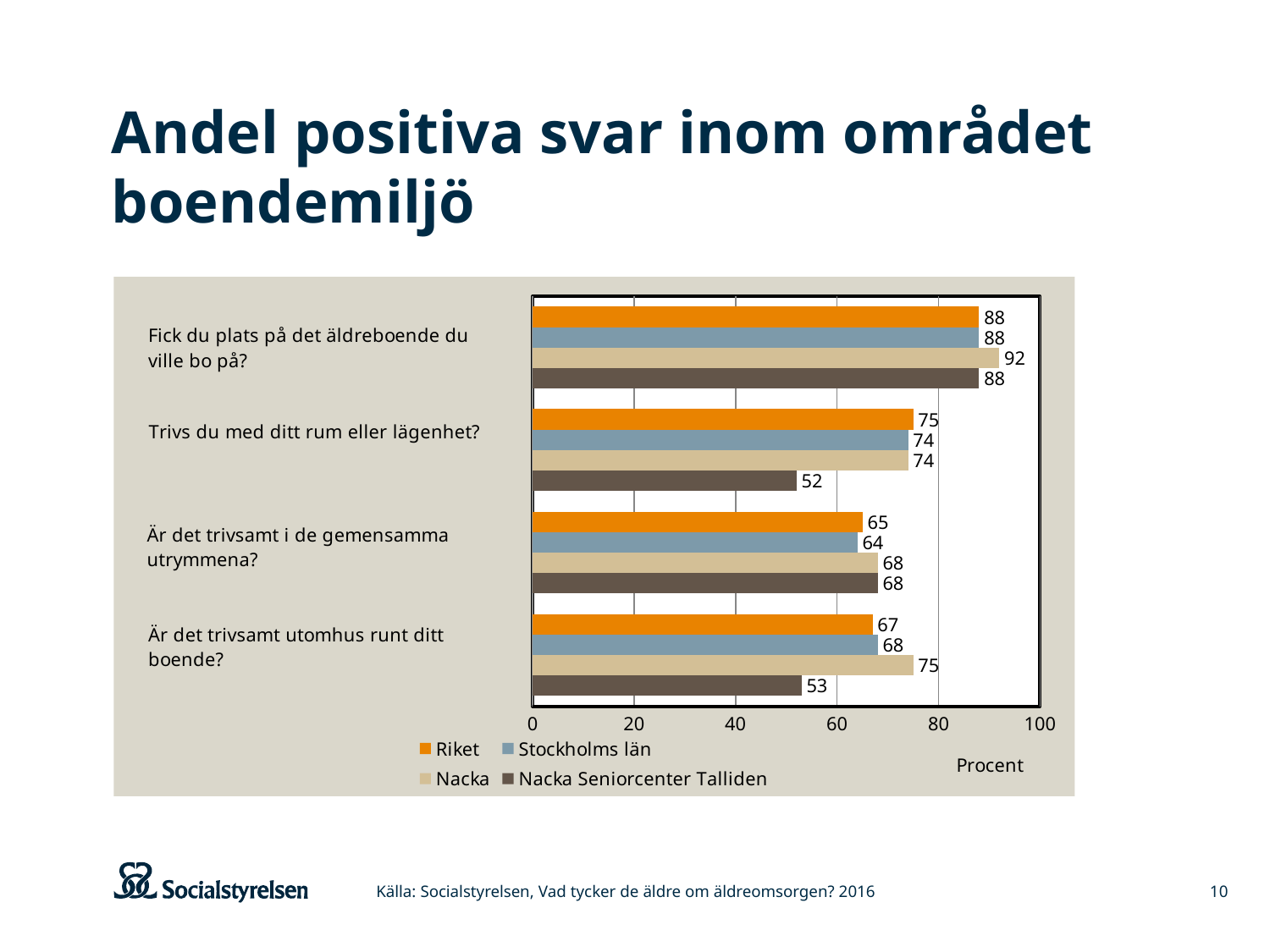
How many questions (categories) are shown on the chart? 4 What is the value for Nacka on "Fick du plats på det äldreboende du ville bo på?"? 92 Which series has the highest value on "Fick du plats på det äldreboende du ville bo på?"? Nacka What is the value for Stockholms län on "Är det trivsamt i de gemensamma utrymmena?"? 64 What is the difference between Nacka and Nacka Seniorcenter Talliden on "Trivs du med ditt rum eller lägenhet?"? 22 What kind of chart is shown on the slide? Bar chart How many series does the legend list? 4 Which is larger on "Är det trivsamt utomhus runt ditt boende?": Nacka or Riket? Nacka What is the value for Riket on "Är det trivsamt utomhus runt ditt boende?"? 67 What unit is shown on the horizontal axis of the chart? Procent What is the value for Nacka Seniorcenter Talliden on "Trivs du med ditt rum eller lägenhet?"? 52 Which series has the lowest value on "Är det trivsamt utomhus runt ditt boende?"? Nacka Seniorcenter Talliden